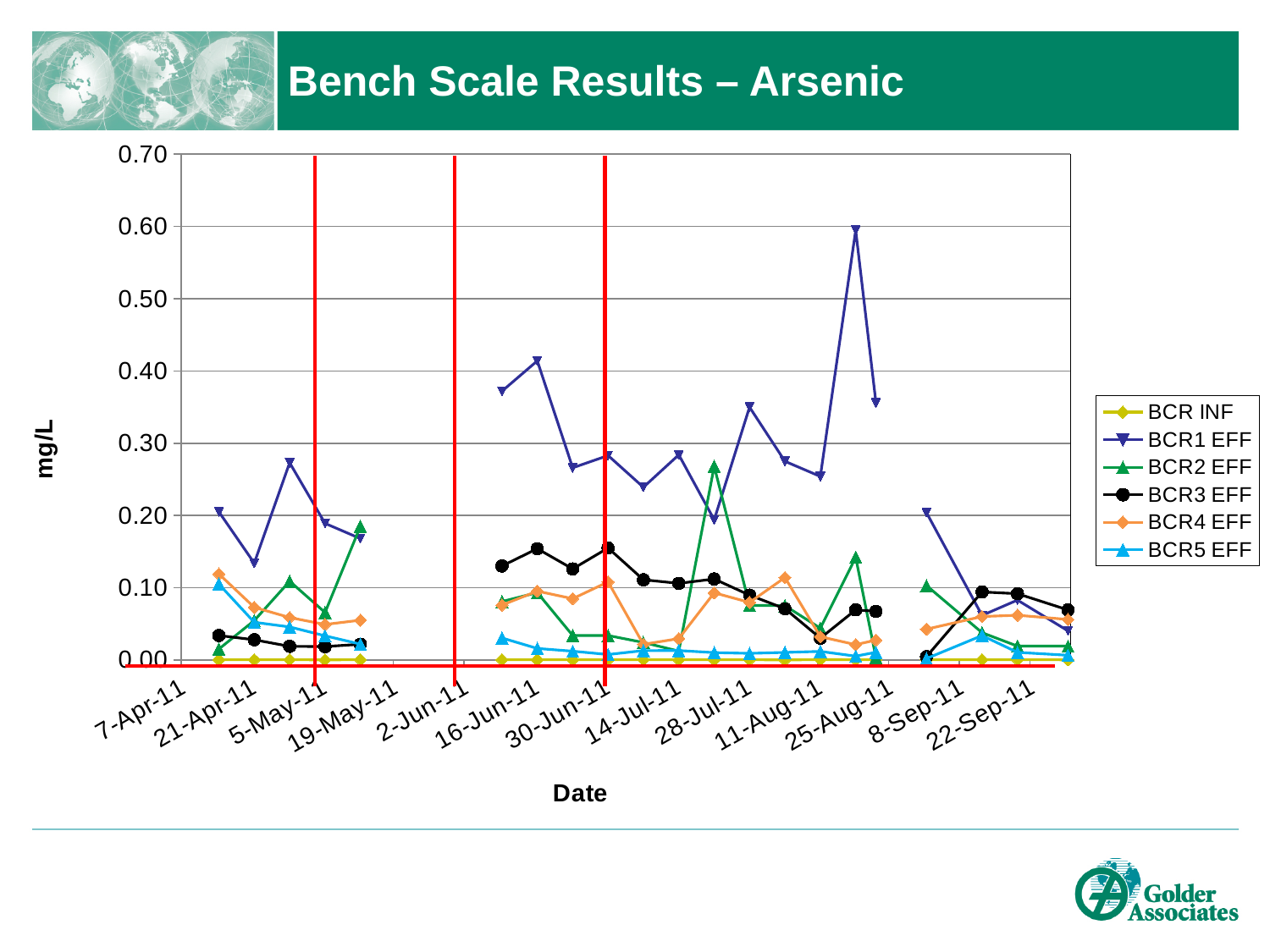
What is the title of the chart? Bench Scale Results – Arsenic What kind of chart is shown on the slide? line chart What is the label on the y axis? mg/L Which series is higher around 16-Jun-11, BCR1 EFF or BCR5 EFF? BCR1 EFF Are the values of BCR INF greater or less than 0.10? less Are all values of BCR3 EFF greater or less than 0.20? less How many date labels are shown along the x axis? 13 Which series reaches the highest value on the chart? BCR1 EFF Is the peak value of BCR2 EFF near 28-Jul-11 greater or less than 0.20? greater How many series does the legend list? 6 What is the highest value shown on the y axis? 0.70